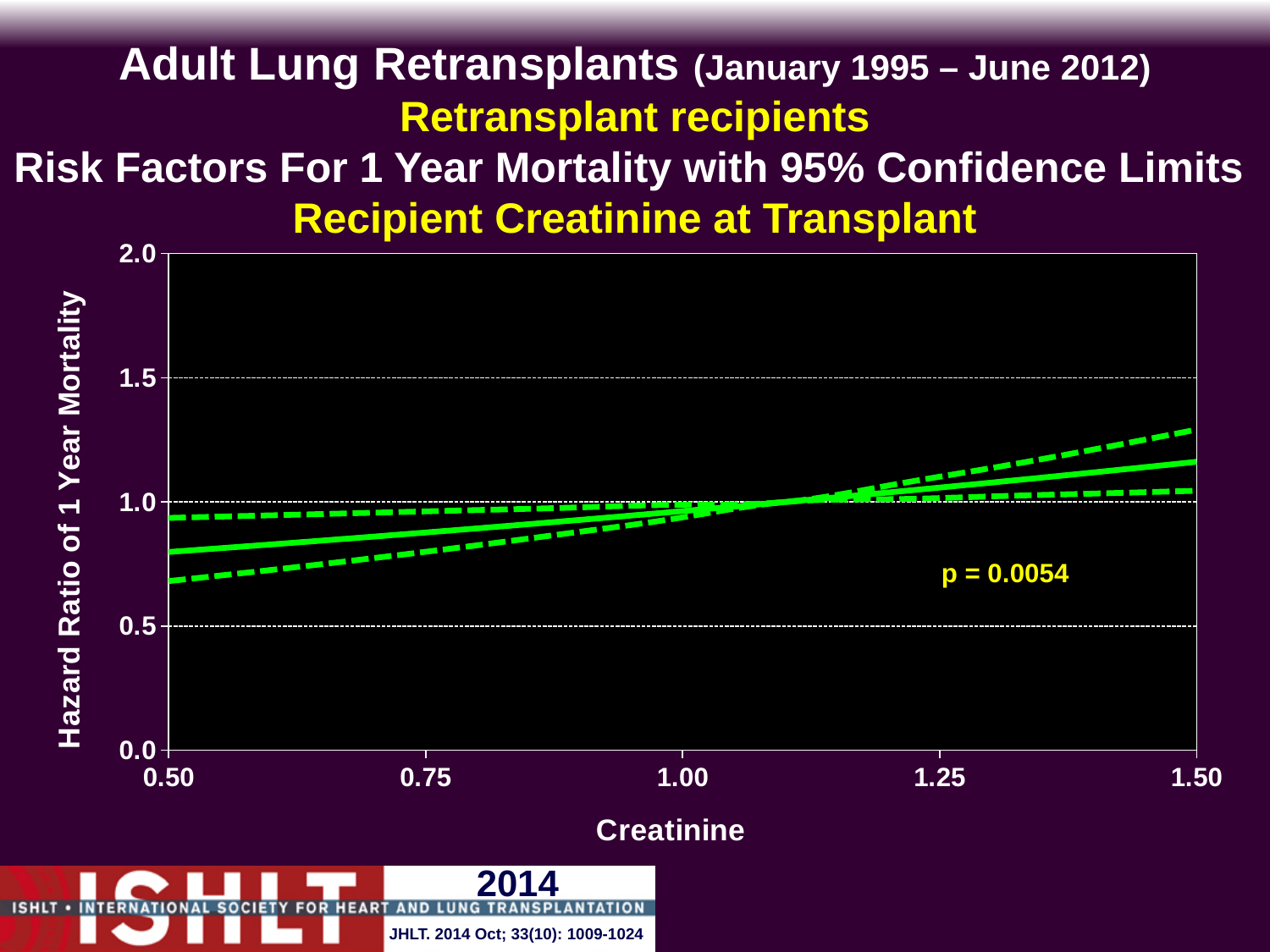
Is the hazard ratio (solid line) at a creatinine of 1.50 greater or less than 1.0? greater What is the label of the x axis? Creatinine How many lines are plotted on the chart? 3 Is the hazard ratio (solid line) higher at a creatinine of 1.50 or at a creatinine of 0.50? 1.50 Does the hazard ratio of 1 year mortality rise or fall as creatinine increases from 0.50 to 1.50? rise Is the hazard ratio (solid line) at a creatinine of 1.50 greater or less than 1.5? less Is the hazard ratio (solid line) at a creatinine of 0.50 greater or less than 1.0? less What p-value is printed on the chart? p = 0.0054 What is the maximum value shown on the y axis? 2.0 What kind of chart is shown on the slide? line chart